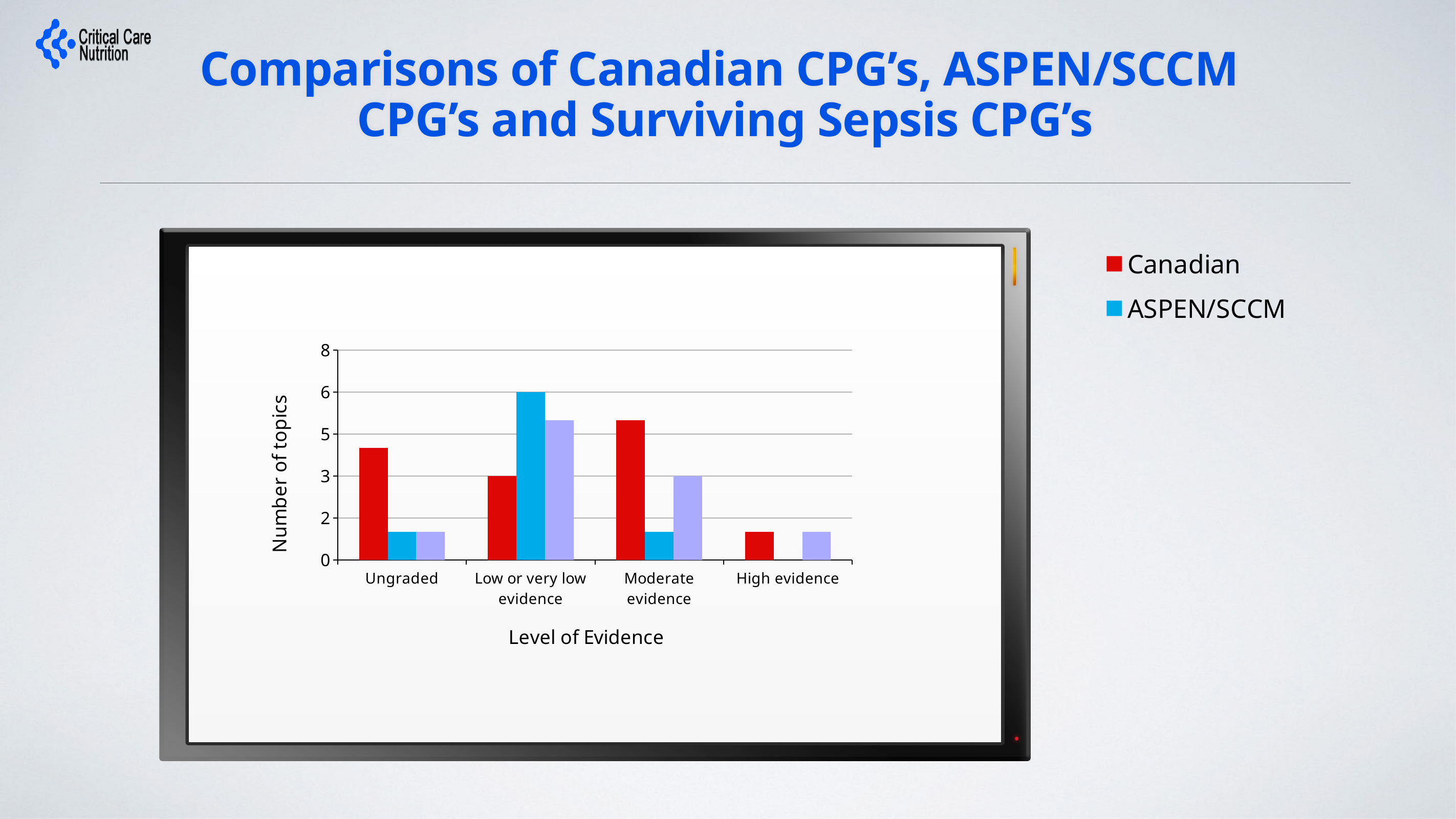
At Low or very low evidence, which series has the larger value, Canadian or ASPEN/SCCM? ASPEN/SCCM What is the number of topics for Canadian at Low or very low evidence? 3 At Ungraded, which series has the larger value, Canadian or ASPEN/SCCM? Canadian For which level of evidence is the Canadian value lowest? High evidence For which level of evidence is the Canadian value highest? Moderate evidence How many levels of evidence are shown on the x axis of the chart? 4 What is the number of topics for ASPEN/SCCM at Low or very low evidence? 6 What is the title of the chart's x axis? Level of Evidence How many series does the chart's legend list? 2 For which level of evidence is the ASPEN/SCCM value highest? Low or very low evidence What kind of chart is shown on the slide? bar chart